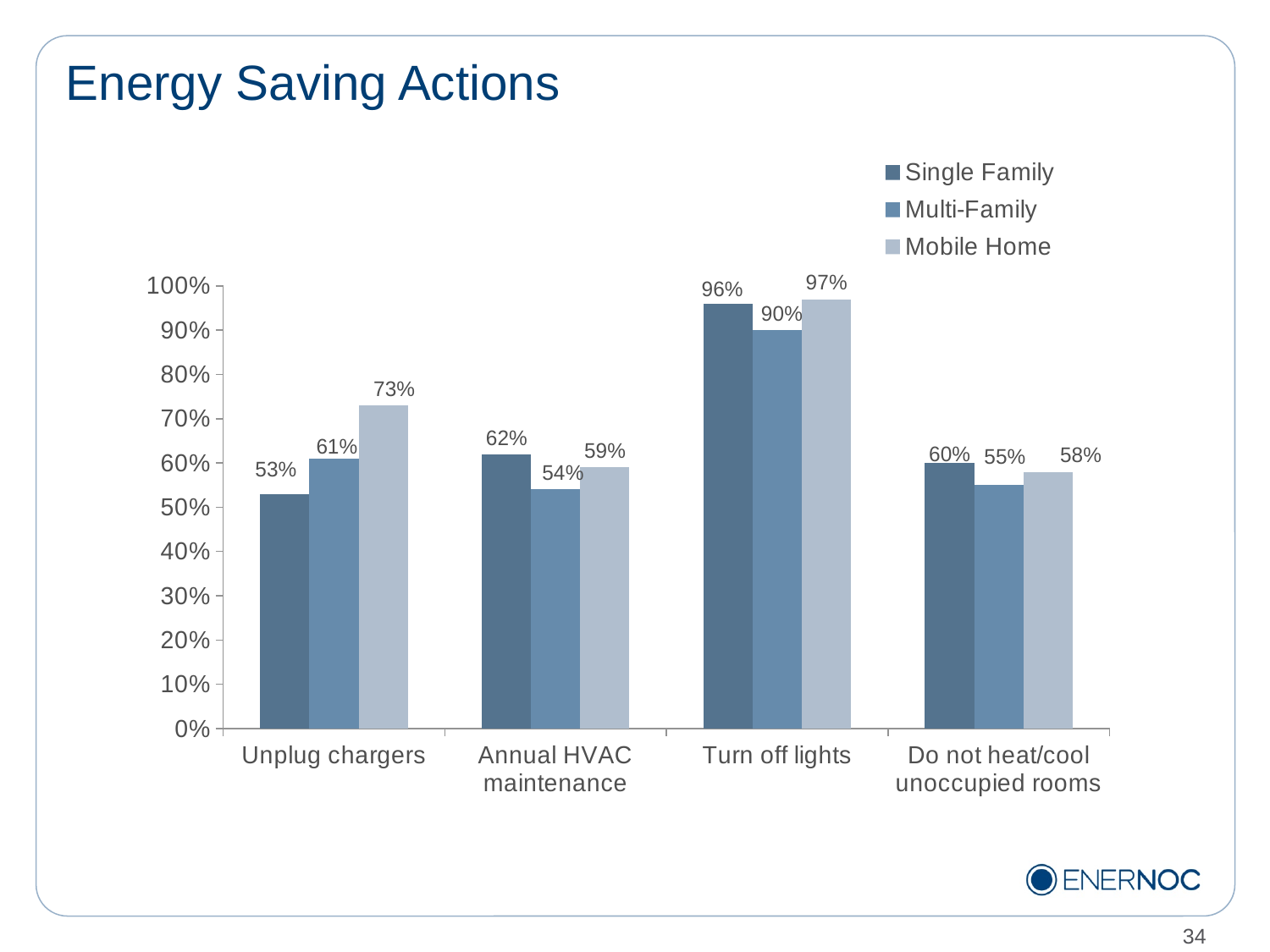
What is the difference between the Mobile Home and Single Family values for Unplug chargers? 20% Which category has the lowest Mobile Home value? Do not heat/cool unoccupied rooms How many series does the legend list? 3 What is the Multi-Family value for Turn off lights? 90% How many categories are shown on the x axis? 4 What is the title of the slide? Energy Saving Actions Which category has the highest Single Family value? Turn off lights What kind of chart is shown on the slide? Bar chart What is the Single Family value for Annual HVAC maintenance? 62% What is the Mobile Home value for Unplug chargers? 73% Which series is shown in the lightest colour in the legend? Mobile Home For Annual HVAC maintenance, which is larger: the Single Family value or the Multi-Family value? Single Family